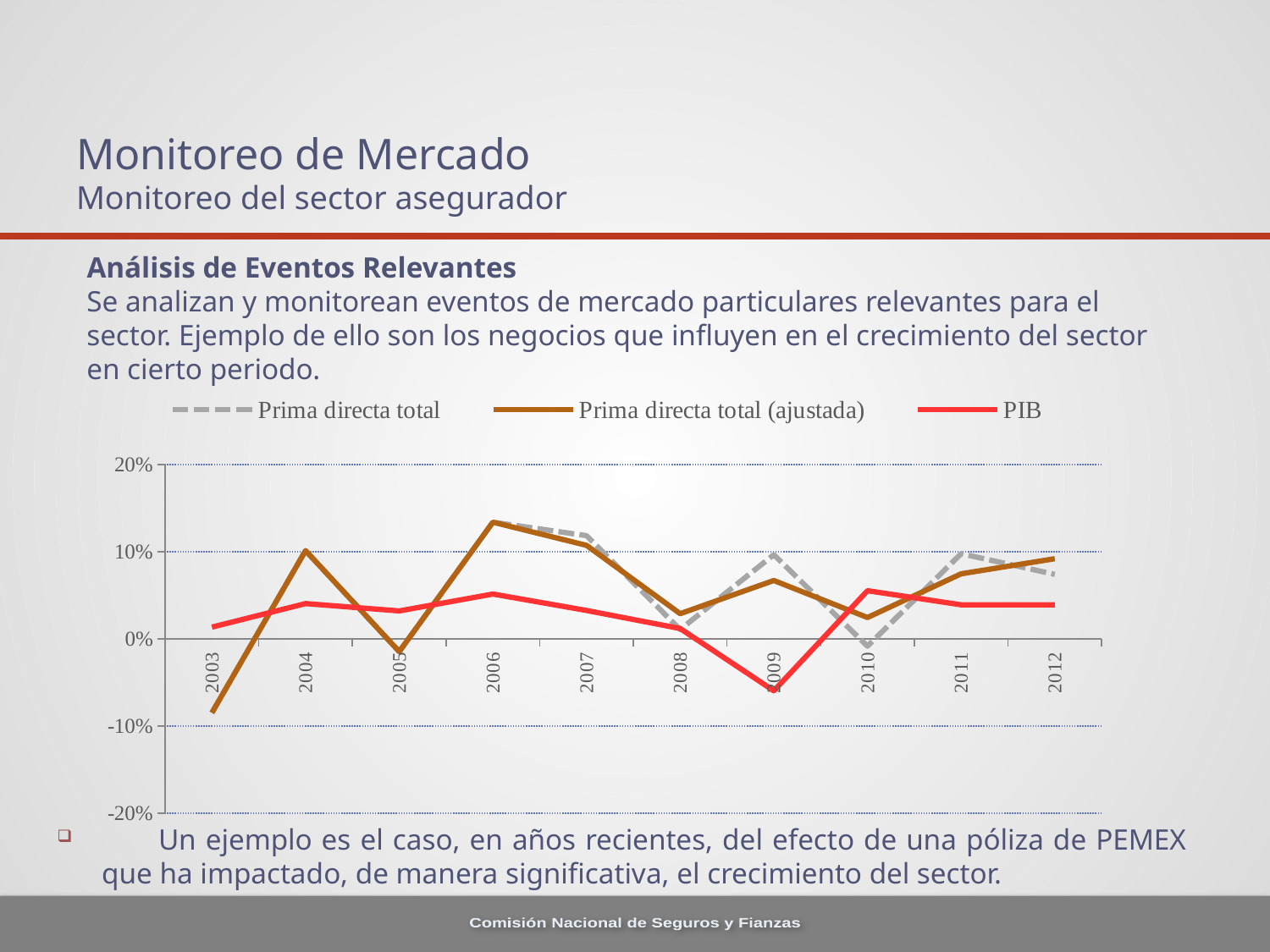
Is the Prima directa total (ajustada) value for 2003 greater or less than 0%? less How many series does the chart legend list? 3 In which year does the PIB series reach its lowest value? 2009 How many years are shown along the x axis of the chart? 10 What kind of chart is shown on the slide? line chart In which year does the Prima directa total (ajustada) series reach its highest value? 2006 Is the PIB value for 2006 greater or less than 10%? less Is the Prima directa total (ajustada) value for 2006 greater or less than 10%? greater In 2004, which is larger: Prima directa total (ajustada) or PIB? Prima directa total (ajustada) What colour is the PIB line in the chart? red Which series in the chart is drawn with a dashed line? Prima directa total